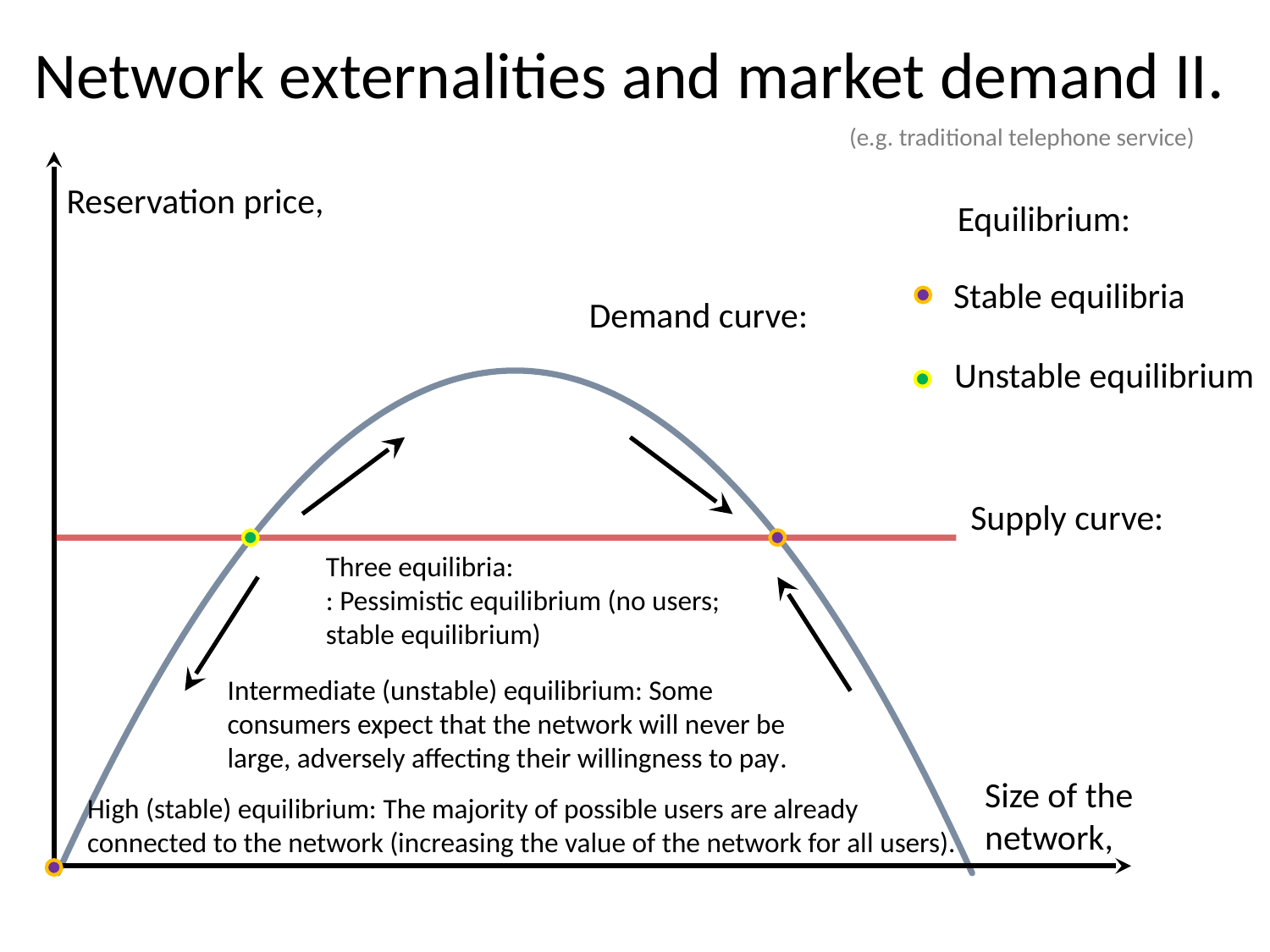
What is the label of the vertical axis? Reservation price Does the demand curve rise or fall after its peak as the size of the network continues to increase? fall What is the label of the horizontal axis? Size of the network Does the demand curve rise or fall as the size of the network increases from zero up to its peak? rise How many entries does the equilibrium legend list? 2 How many of the marked equilibria are stable equilibria? 2 How many equilibrium points are marked on the chart where the demand curve meets the supply curve or the axis? 3 How many of the marked equilibria are unstable? 1